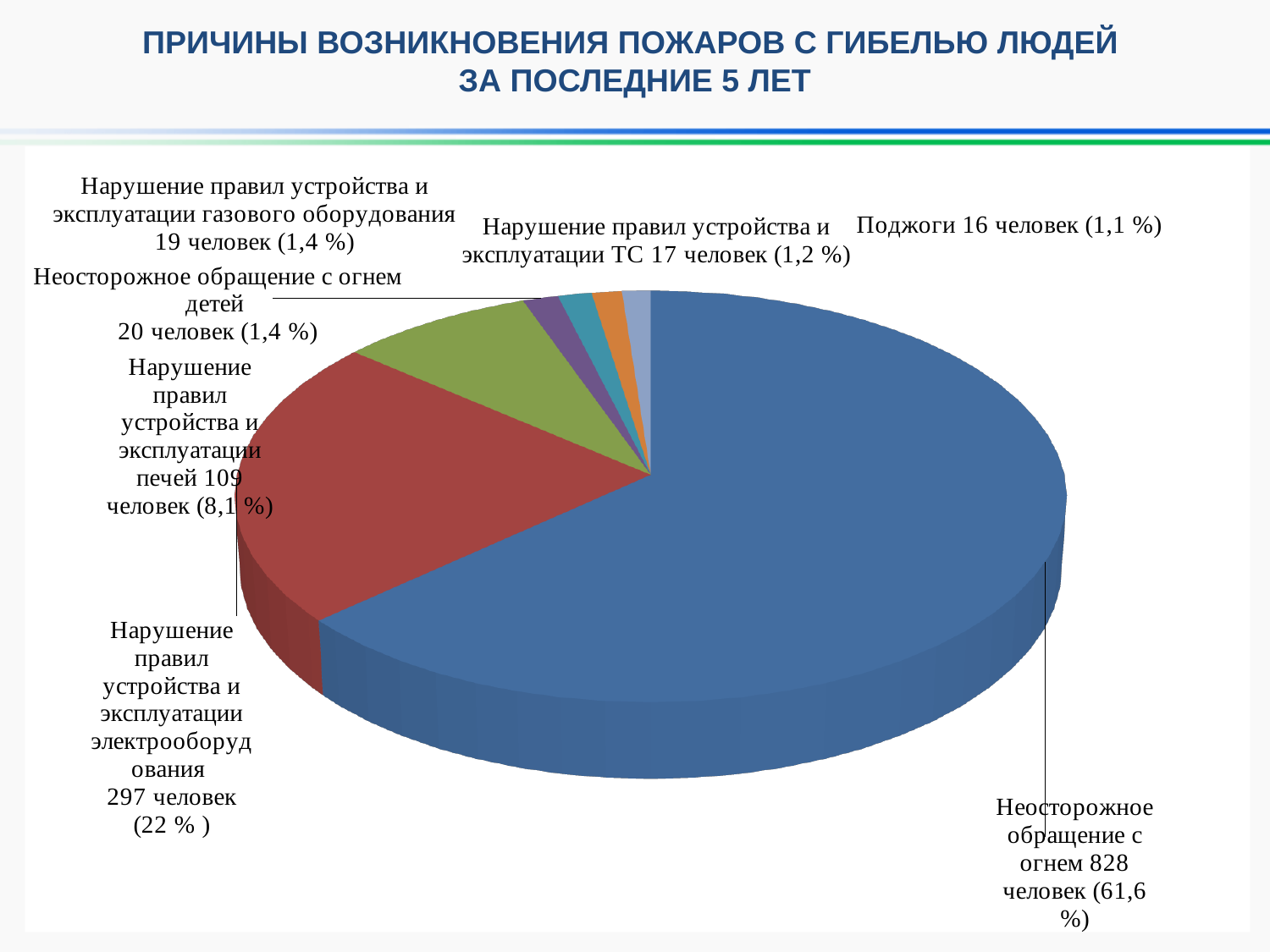
How many people died in fires caused by "Поджоги"? 16 человек What share of the pie does "Неосторожное обращение с огнем" account for? 61,6 % How many people died in fires caused by "Неосторожное обращение с огнем"? 828 человек How many categories (causes) does the pie chart show? 7 What share of the pie does "Нарушение правил устройства и эксплуатации печей" account for? 8,1 % What is the title of the slide? ПРИЧИНЫ ВОЗНИКНОВЕНИЯ ПОЖАРОВ С ГИБЕЛЬЮ ЛЮДЕЙ ЗА ПОСЛЕДНИЕ 5 ЛЕТ How many people died in fires caused by "Нарушение правил устройства и эксплуатации электрооборудования"? 297 человек What kind of chart is shown on the slide? Pie chart Which has more deaths: "Нарушение правил устройства и эксплуатации печей" or "Неосторожное обращение с огнем детей"? Нарушение правил устройства и эксплуатации печей What is the difference in the number of people between "Неосторожное обращение с огнем" (828) and "Нарушение правил устройства и эксплуатации электрооборудования" (297)? 531 человек Which cause accounts for the largest slice of the pie? Неосторожное обращение с огнем Which cause accounts for the smallest slice of the pie? Поджоги